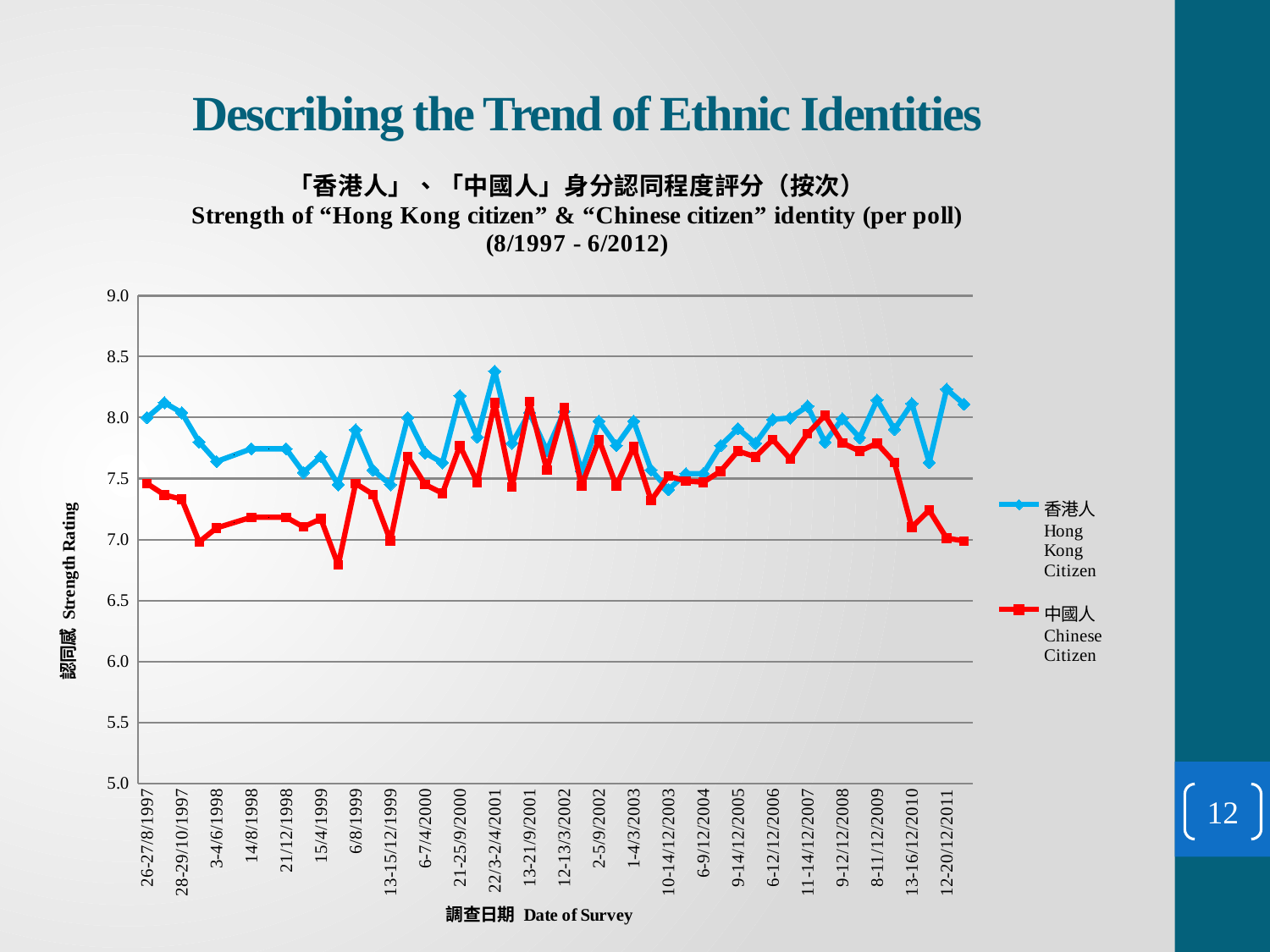
At 26-27/8/1997, which series has the larger value, Hong Kong Citizen or Chinese Citizen? Hong Kong Citizen At 13-16/12/2010, which series has the larger value, Hong Kong Citizen or Chinese Citizen? Hong Kong Citizen What is the label of the vertical axis? 認同感 Strength Rating Does the Chinese Citizen series rise or fall from 11-14/12/2007 to 12-20/12/2011? Fall Is the value for Chinese Citizen at 15/4/1999 greater or less than 7.0? greater Is the value for Hong Kong Citizen at 22/3-2/4/2001 greater or less than 8.0? greater Is the value for Hong Kong Citizen at 13-15/12/1999 greater or less than 8.0? less Which series reaches the lowest point on the chart? Chinese Citizen How many series does the legend list? 2 What kind of chart is shown on the slide? Line chart